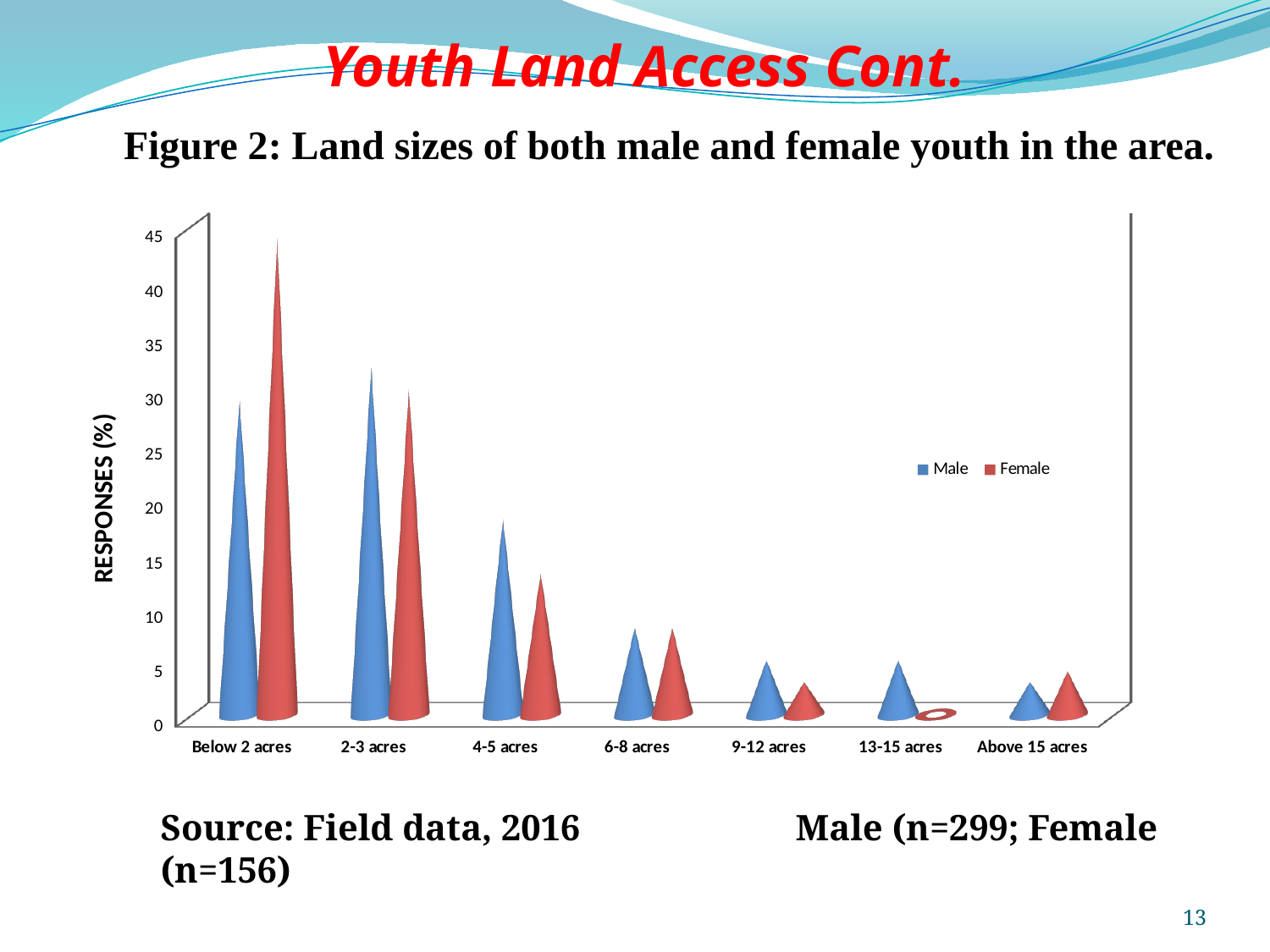
How many land-size categories are shown on the x axis? 7 Is the Female value for Below 2 acres greater or less than 40? greater Which land-size category has the highest Female value? Below 2 acres Is the Male value for 6-8 acres greater or less than 10? less What is the title of the y axis? RESPONSES (%) Is the Male value for 4-5 acres greater or less than 15? greater How many series does the legend list? 2 What is the Female value for 13-15 acres? 0 For 4-5 acres, which is larger, the Male or the Female value? Male Which land-size category has the lowest Female value? 13-15 acres For Below 2 acres, which is larger, the Male or the Female value? Female What kind of chart is shown on the slide? Bar chart